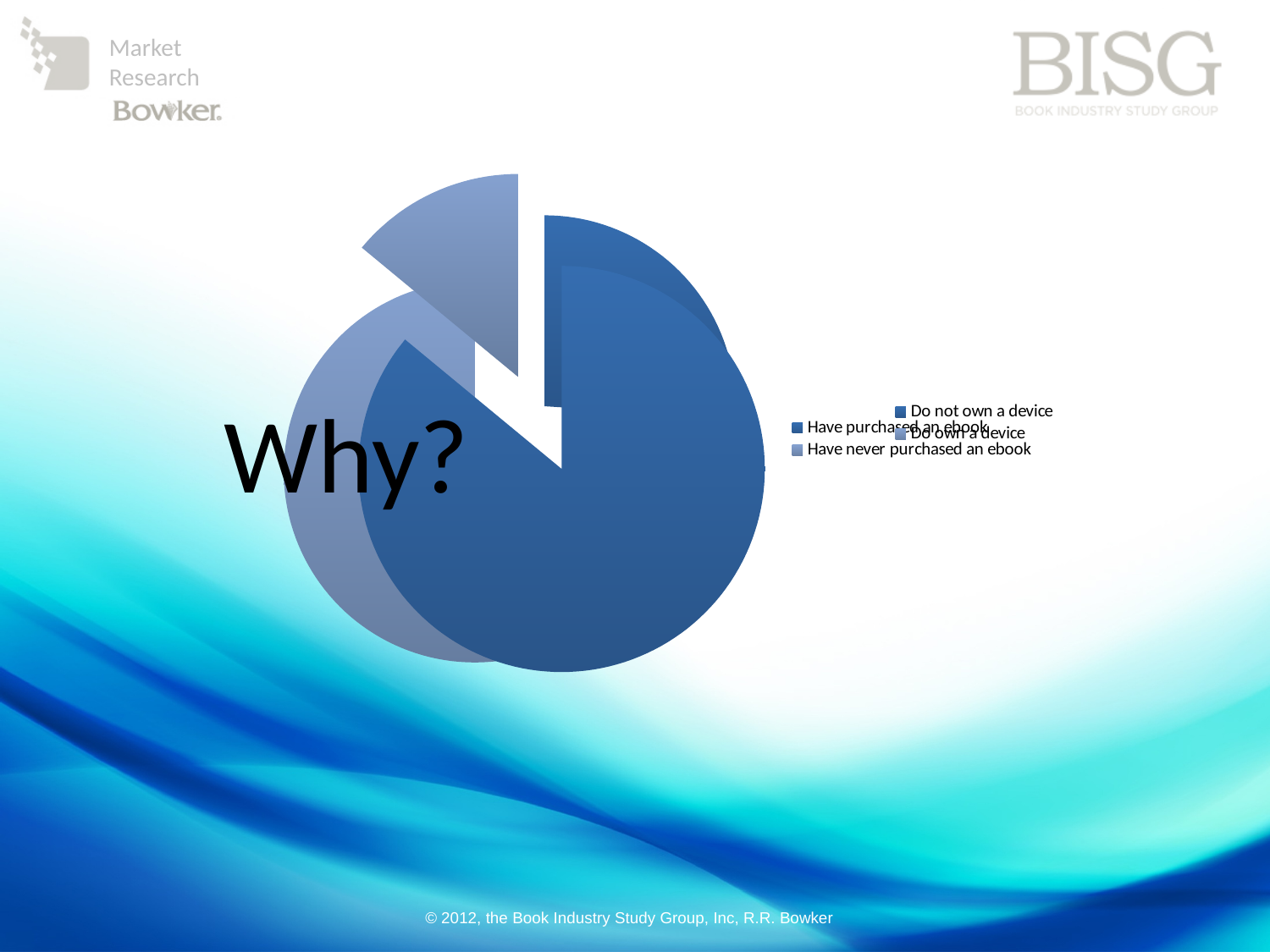
Which legend entry is listed first in the legend that includes 'Have never purchased an ebook'? Have purchased an ebook In the front pie chart, is the light blue exploded slice greater or less than half of the pie? less How many slices does the front pie chart have? 2 What kind of chart is shown on the slide? pie chart How many pie charts are shown on the slide? 2 In the front pie chart, is the dark blue slice greater or less than half of the pie? greater In the front pie chart, which slice is larger, the dark blue slice or the light blue slice? dark blue slice What is the large text shown to the left of the pie charts? Why?